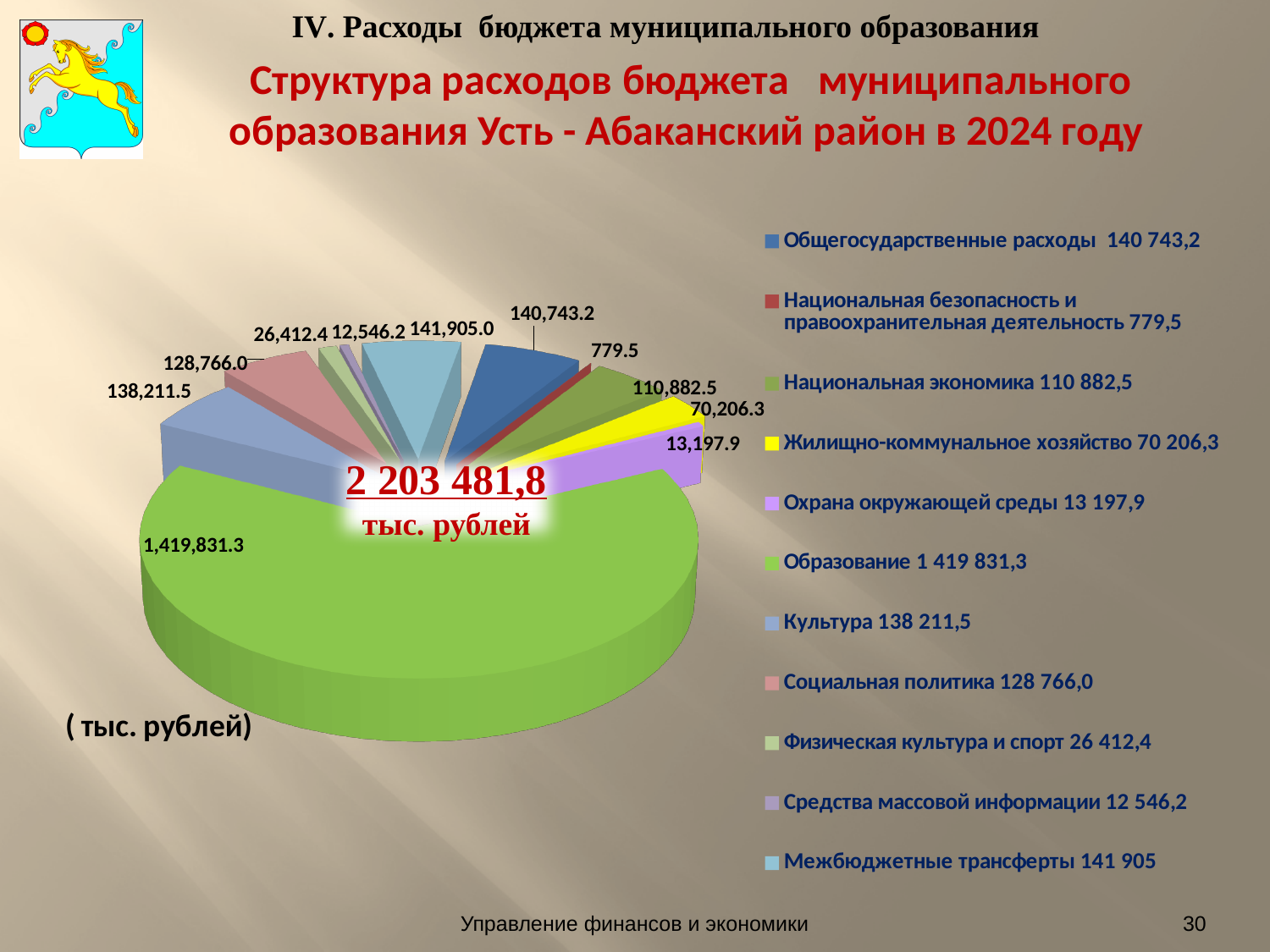
What is the value for Образование on the pie chart? 1,419,831.3 What is the value for Культура on the pie chart? 138,211.5 What kind of chart is shown on the slide? Pie chart Which category has the smallest value on the pie chart? Национальная безопасность и правоохранительная деятельность How many categories does the pie chart show? 11 What share of the total 2 203 481,8 does Образование (1,419,831.3) represent, to one decimal place? 64.4% What is the value for Жилищно-коммунальное хозяйство on the pie chart? 70,206.3 What total is printed in the centre of the pie chart? 2 203 481,8 тыс. рублей Which category has the largest slice of the pie chart? Образование Which is larger: Общегосударственные расходы or Межбюджетные трансферты? Межбюджетные трансферты What is the difference between the values for Культура and Социальная политика? 9,445.5 What is the difference between the values for Национальная экономика and Жилищно-коммунальное хозяйство? 40,676.2